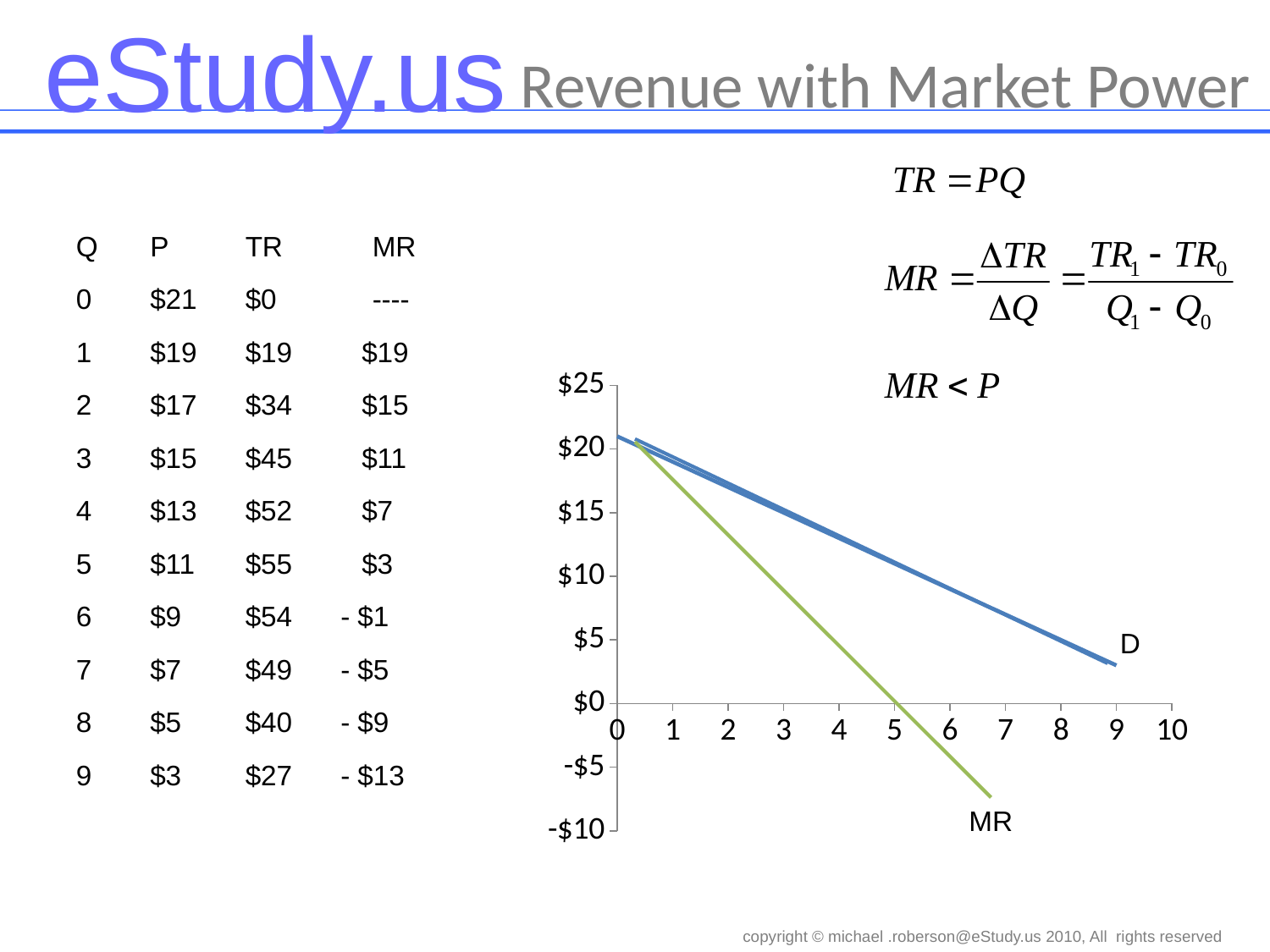
What kind of chart is shown on the slide? line chart Is the value of the MR line at quantity 7 greater or less than $0? less At quantity 4, which line is higher, D or MR? D What is the highest value shown on the chart's y axis? $25 Does the MR line rise or fall as quantity increases along the x axis? fall How many lines are plotted on the chart? 2 Is the value of the MR line at quantity 2 greater or less than $20? less Is the value of the D line at quantity 5 greater or less than $15? less What are the labels of the two lines on the chart? D and MR Does the D line rise or fall as quantity increases along the x axis? fall